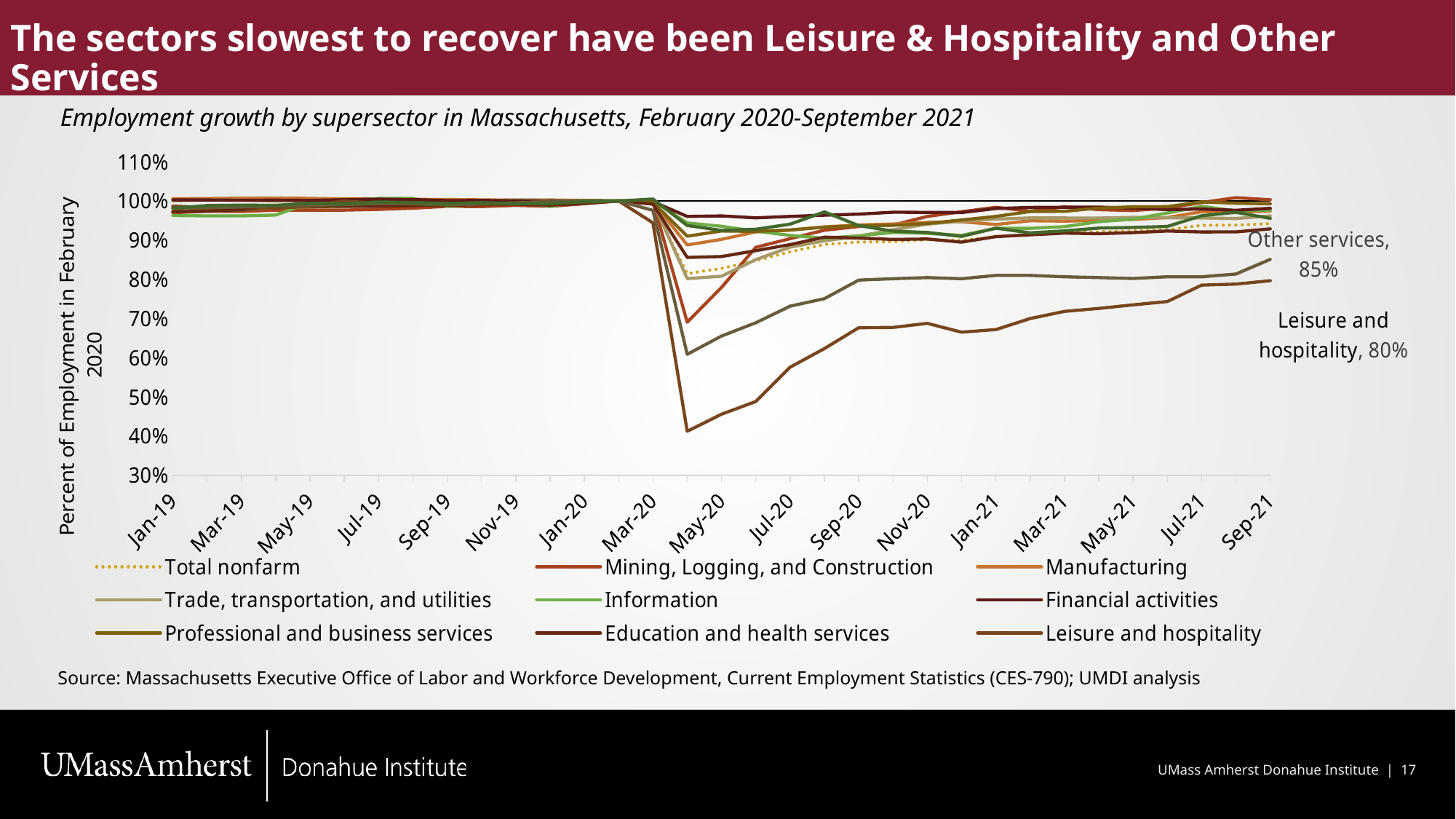
What kind of chart is shown on the slide? Line chart How many series does the legend list? 9 Is the value for Other services in April 2020 greater or less than 70%? less What is the value labelled for Leisure and hospitality at the end of the chart (Sep-21)? 80% What is the value labelled for Other services at the end of the chart (Sep-21)? 85% At Sep-21, which is higher: Other services or Leisure and hospitality? Other services Is the lowest value of the Leisure and hospitality line greater or less than 50%? less What is the difference between the labelled Sep-21 values for Other services and Leisure and hospitality? 5 percentage points Does the Leisure and hospitality line rise or fall from May-20 to Sep-21? rise Which series is drawn with a dotted line? Total nonfarm Which series fell to the lowest level in April 2020? Leisure and hospitality What is the label on the vertical axis of the chart? Percent of Employment in February 2020